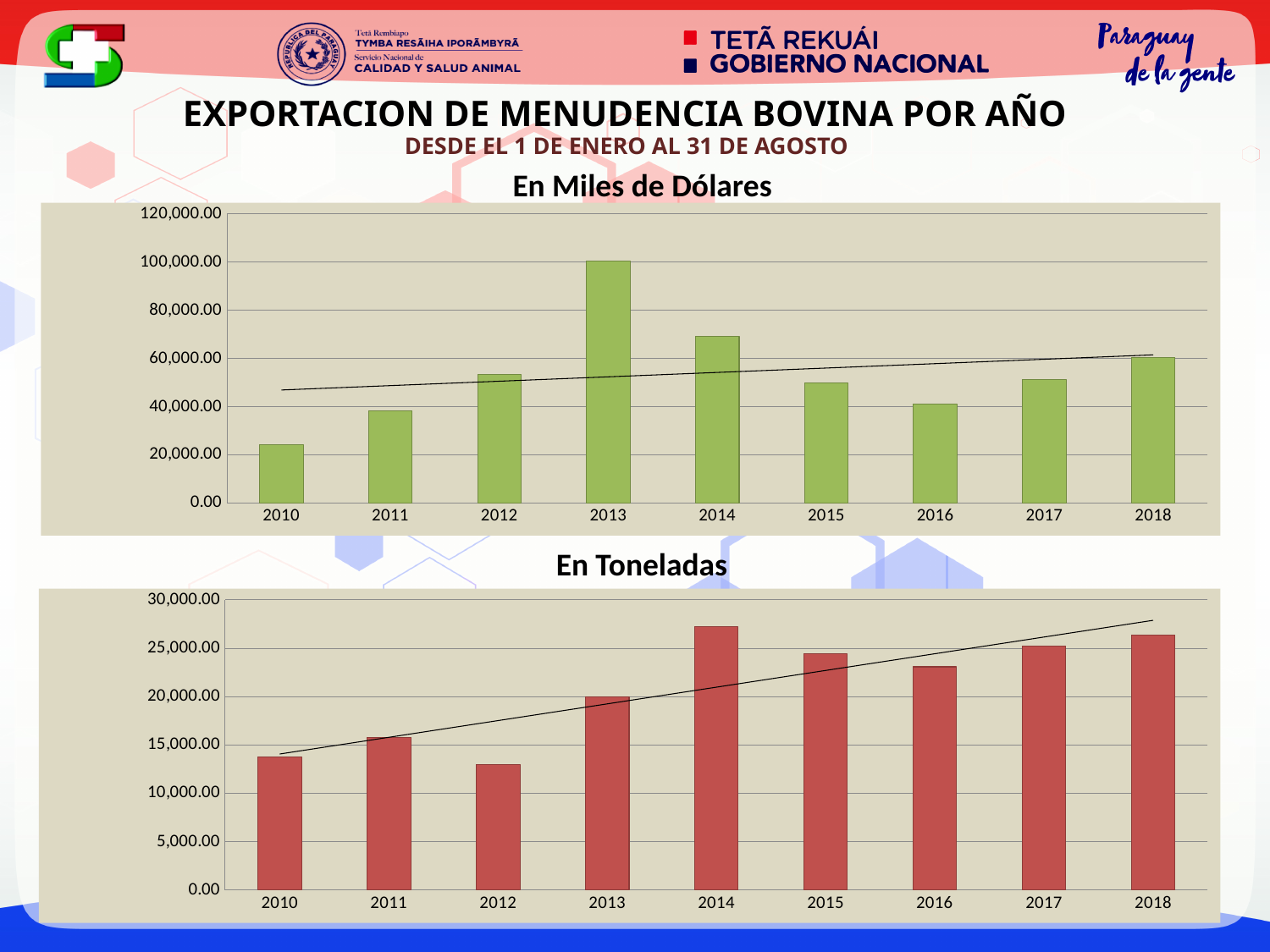
In the 'En Miles de Dólares' chart, which year has the highest value? 2013 In the 'En Miles de Dólares' chart, which year has the lowest value? 2010 In the 'En Toneladas' chart, is the value for 2014 greater or less than 25,000.00? greater In the 'En Miles de Dólares' chart, is the value for 2010 greater or less than 40,000.00? less In the 'En Toneladas' chart, is the value for 2012 greater or less than 15,000.00? less In the 'En Toneladas' chart, which year has the highest value? 2014 In the 'En Miles de Dólares' chart, which is larger, the value for 2014 or the value for 2015? 2014 In the 'En Toneladas' chart, which is larger, the value for 2013 or the value for 2016? 2016 In the 'En Toneladas' chart, do the values generally rise or fall from 2010 to 2018? rise How many years are shown on the x axis of the 'En Miles de Dólares' chart? 9 What kind of chart is the 'En Toneladas' chart? bar chart